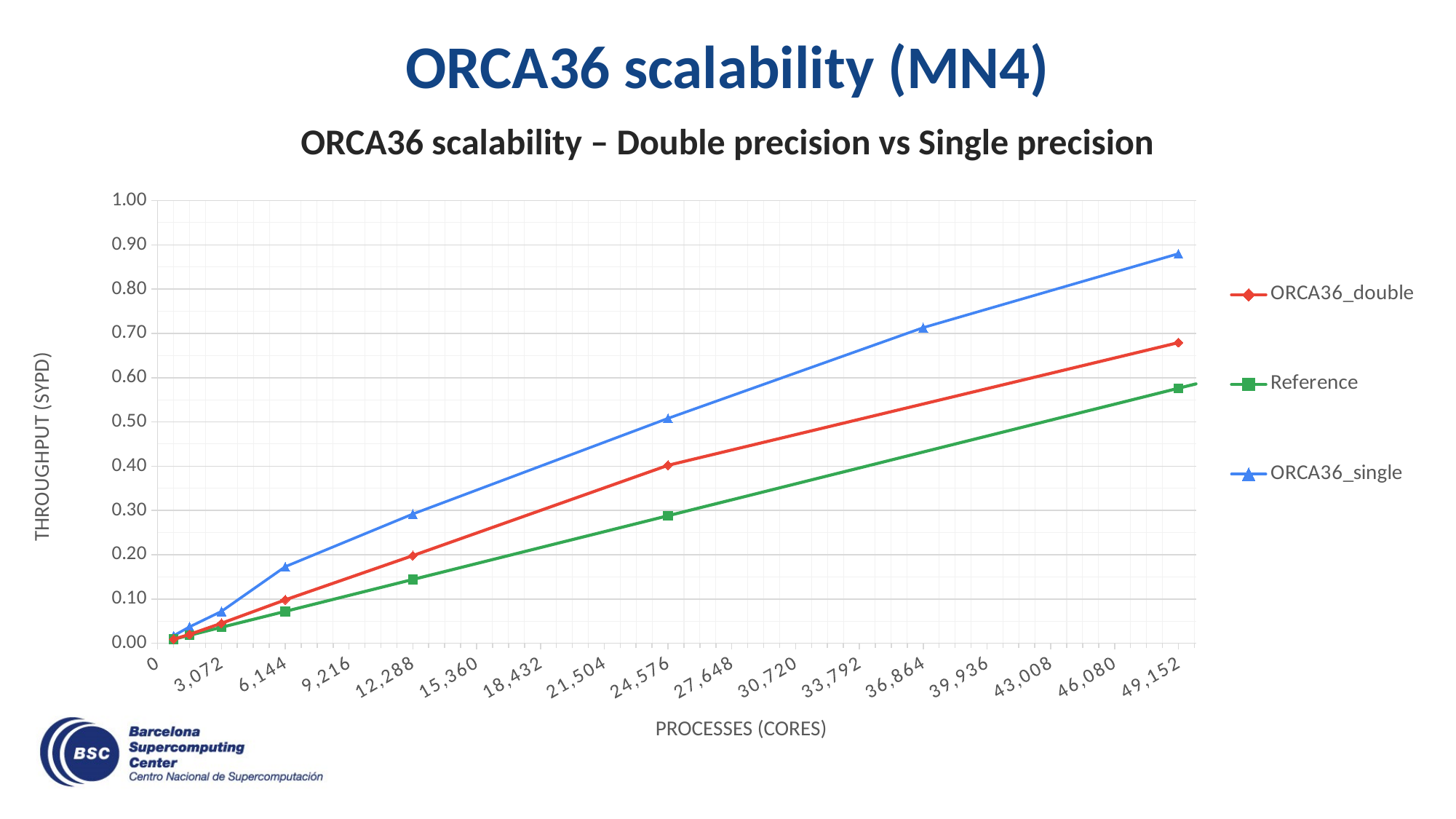
At 36,864 processes, which has the higher throughput: ORCA36_single or ORCA36_double? ORCA36_single What is the title of the chart? ORCA36 scalability – Double precision vs Single precision What kind of chart is shown on the slide? line chart Is the throughput of ORCA36_single at 49,152 processes greater or less than 0.80? greater Does the throughput of the ORCA36_single series rise or fall as the number of processes increases? rise Is the throughput of ORCA36_double at 49,152 processes greater or less than 0.70? less Is the throughput of Reference at 12,288 processes greater or less than 0.10? greater Which series has the highest throughput at 49,152 processes? ORCA36_single How many series does the legend list? 3 Which series has the lowest throughput at 49,152 processes? Reference At 24,576 processes, which has the higher throughput: ORCA36_double or Reference? ORCA36_double What are the names of the series listed in the legend? ORCA36_double, Reference, ORCA36_single